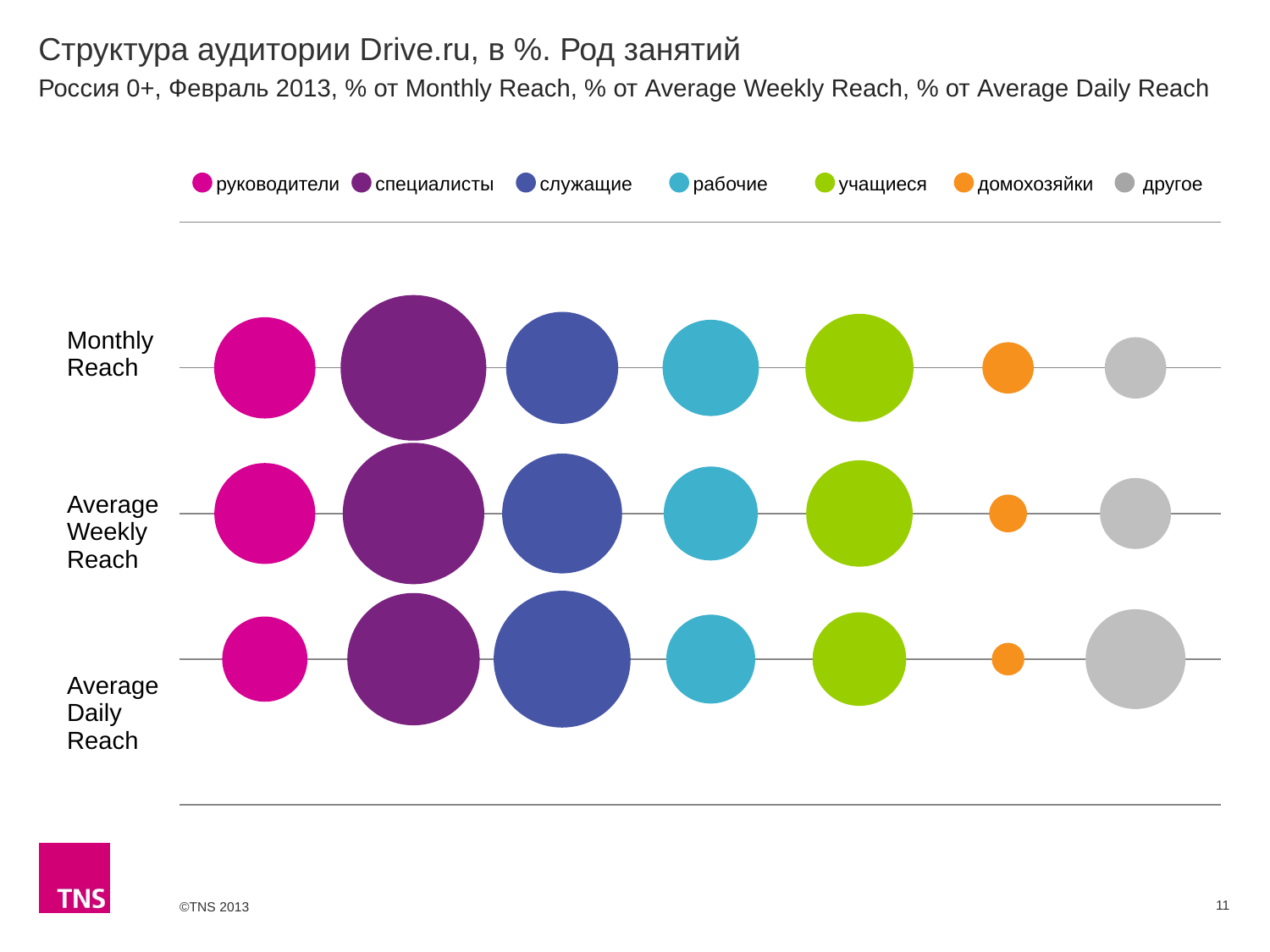
How many series does the legend list? 7 What kind of chart is shown on the slide? bubble chart How many reach rows (categories) are plotted on the chart? 3 In the Average Daily Reach row, which occupation group has the smallest bubble? домохозяйки In the Average Weekly Reach row, which occupation group has the largest bubble? специалисты Does the bubble for руководители grow or shrink going from Monthly Reach to Average Daily Reach? shrink In the Monthly Reach row, which occupation group has the smallest bubble? домохозяйки In the Average Daily Reach row, which bubble is larger: другое or рабочие? другое In the Monthly Reach row, which occupation group has the largest bubble? специалисты Which colour represents учащиеся in the legend? green In the Monthly Reach row, which bubble is larger: учащиеся or рабочие? учащиеся Does the bubble for другое grow or shrink going from Monthly Reach to Average Daily Reach? grow